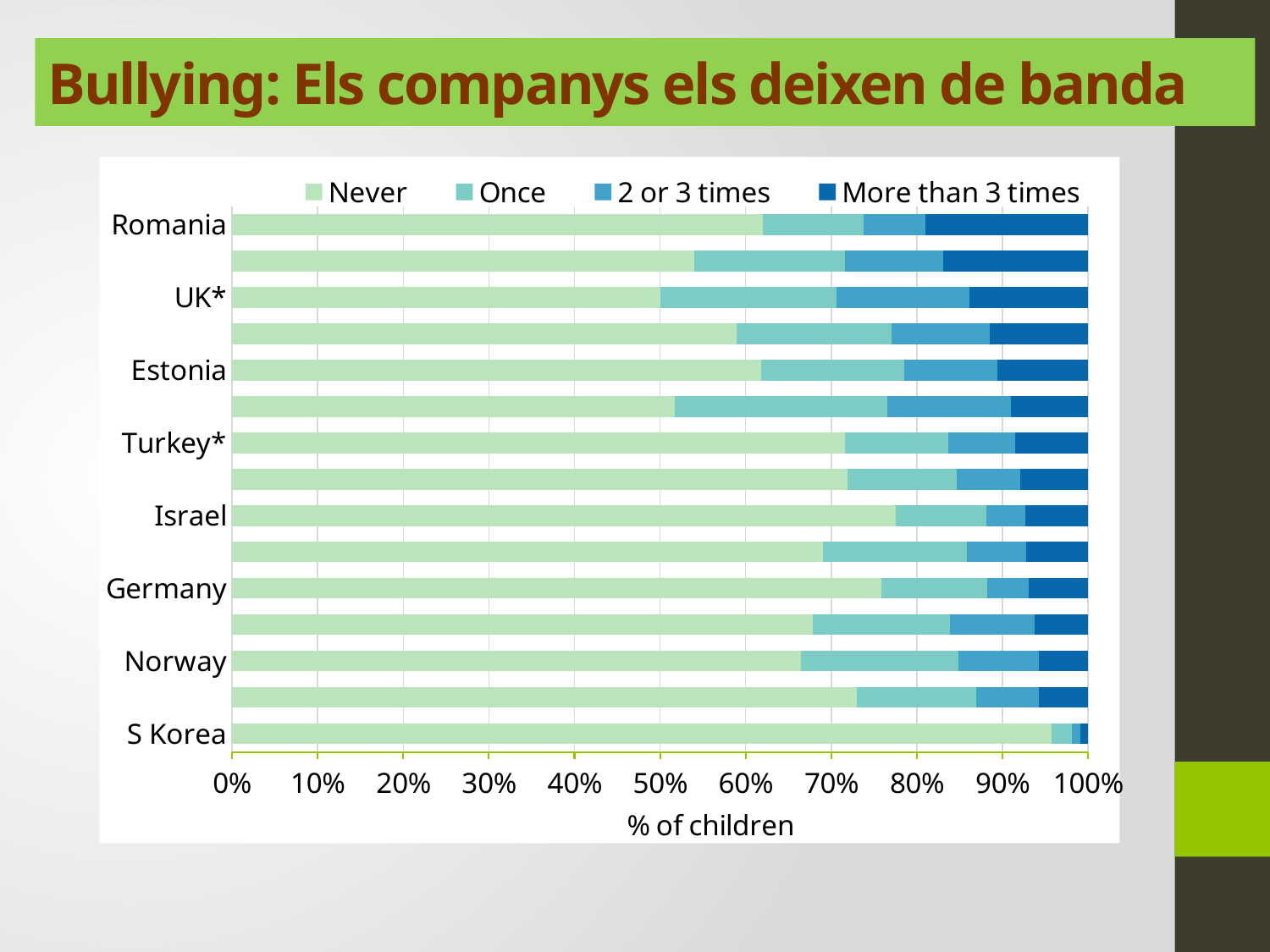
How many series does the legend list? 4 Is the 'Never' value for Norway greater or less than 60%? greater Among the labelled countries, which has the largest 'Never' share? S Korea Is the 'Never' value for Israel greater or less than 70%? greater What is the title of the horizontal axis? % of children What are the four series named in the legend? Never, Once, 2 or 3 times, More than 3 times Is the 'Never' value for Romania greater or less than 50%? greater Which has the larger 'More than 3 times' share, Romania or S Korea? Romania Which has the larger 'Never' share, Romania or Israel? Israel What kind of chart is shown on the slide? Stacked bar chart